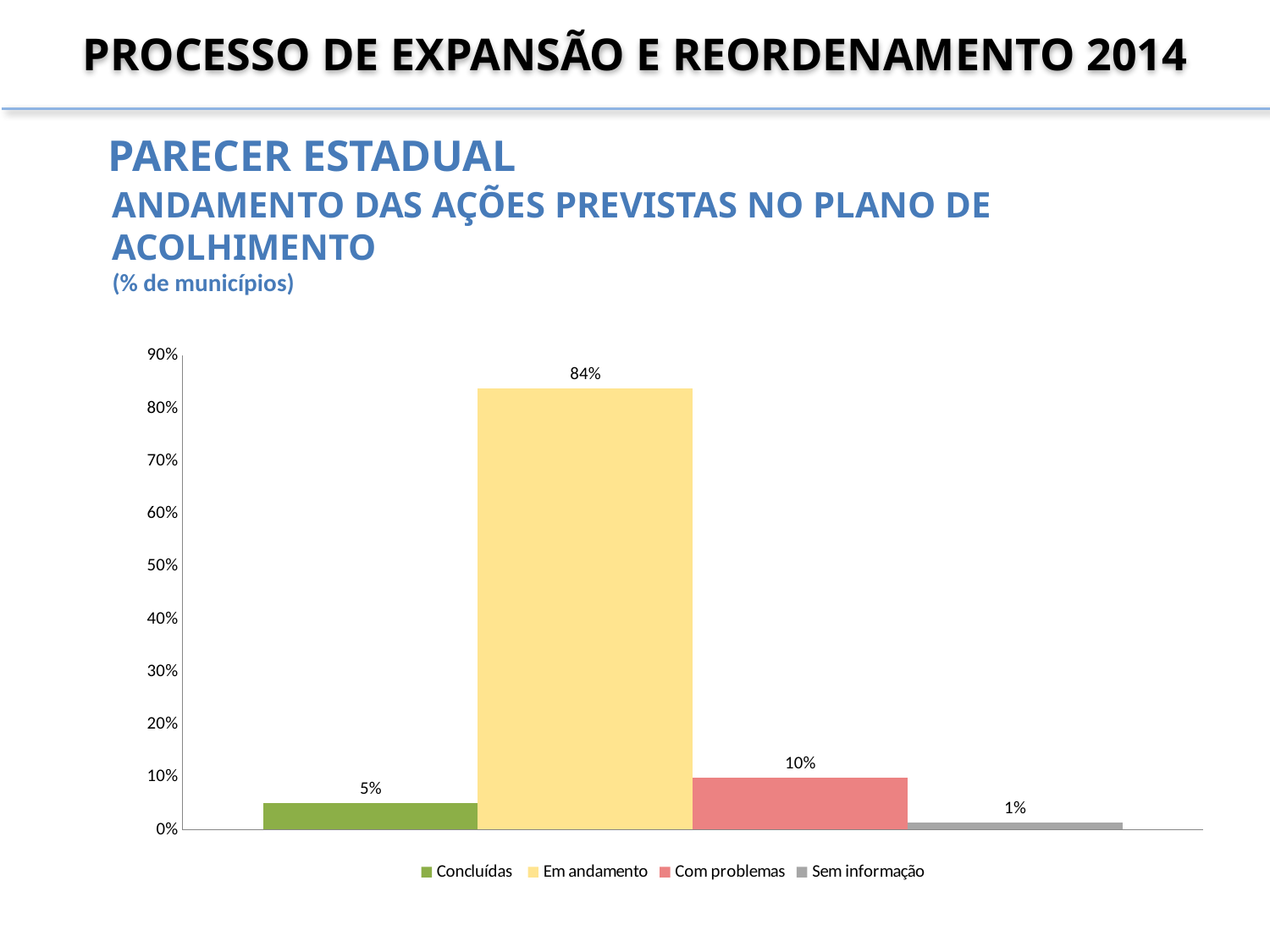
Which category has the highest value? Em andamento Which is larger, the value for 'Com problemas' or the value for 'Concluídas'? Com problemas What is the value shown for 'Com problemas'? 10% Which category has the lowest value? Sem informação What is the value shown for 'Concluídas'? 5% What is the value shown for 'Sem informação'? 1% What kind of chart is shown on the slide? Bar chart What percentage of municipalities have actions 'Em andamento'? 84% How many series does the legend list? 4 Is the value for 'Em andamento' greater or less than 80%? greater What is the difference between the values for 'Em andamento' and 'Com problemas'? 74% What colour is the bar for 'Em andamento'? Yellow